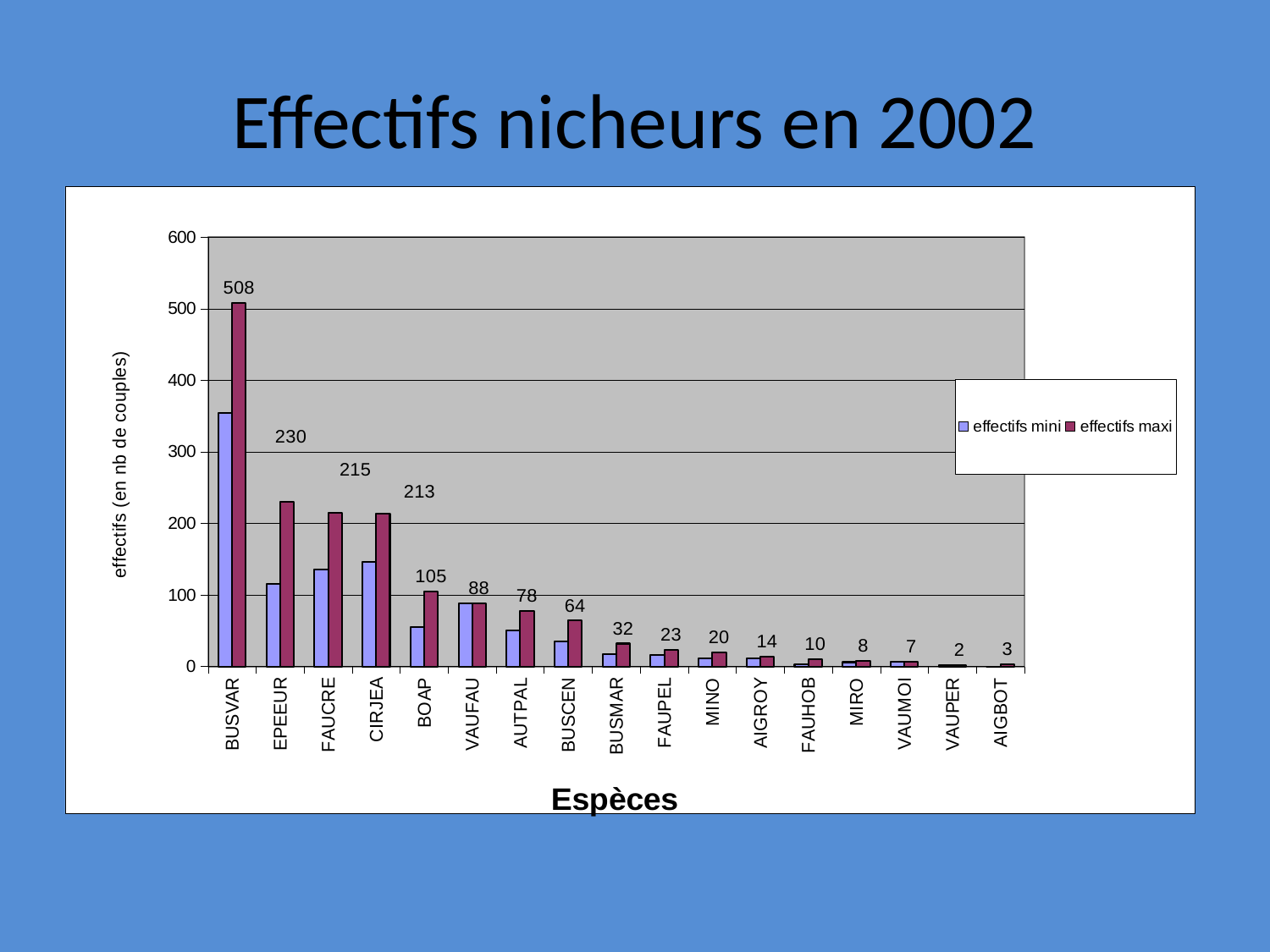
What is the effectifs maxi value for CIRJEA? 213 Is the effectifs mini value for BOAP greater or less than 100? less What is the effectifs maxi value for BUSVAR? 508 How many species are shown on the x axis? 17 Is the effectifs mini value for BUSVAR greater or less than 300? greater What is the effectifs maxi value for BUSMAR? 32 What type of chart is shown on the slide? bar chart What is the difference between the effectifs maxi values for EPEEUR and FAUCRE? 15 Which has a larger effectifs maxi value, BOAP or VAUFAU? BOAP Which species has the lowest effectifs maxi value? VAUPER Which species has the highest effectifs maxi value? BUSVAR How many series does the legend list? 2